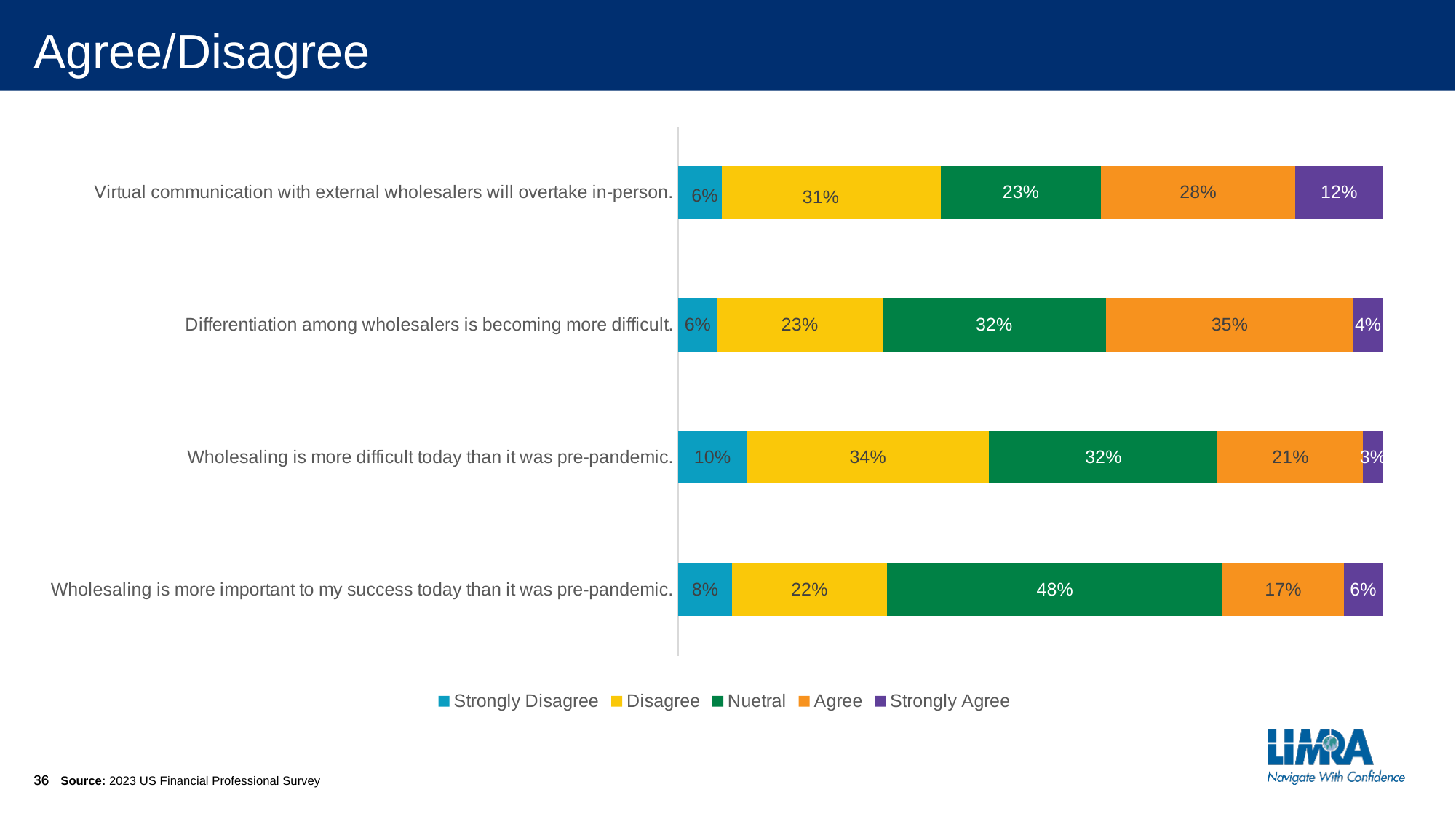
What percentage Agree that differentiation among wholesalers is becoming more difficult? 35% What percentage Strongly Disagree that wholesaling is more difficult today than it was pre-pandemic? 10% What colour represents the Neutral series in the chart? Green How many statements are shown in the chart? 4 Which is larger: the Agree share for "Virtual communication with external wholesalers will overtake in-person" or the Agree share for "Wholesaling is more important to my success today than it was pre-pandemic"? Virtual communication with external wholesalers will overtake in-person. What percentage of respondents are Neutral on the statement "Wholesaling is more important to my success today than it was pre-pandemic"? 48% Which statement has the lowest Strongly Agree share? Wholesaling is more difficult today than it was pre-pandemic. What is the difference between the Disagree share for "Wholesaling is more difficult today than it was pre-pandemic" and for "Wholesaling is more important to my success today than it was pre-pandemic"? 12% Which statement has the highest Neutral share? Wholesaling is more important to my success today than it was pre-pandemic. What kind of chart is shown on the slide? Stacked bar chart How many series does the legend list? 5 What percentage Strongly Agree that virtual communication with external wholesalers will overtake in-person? 12%